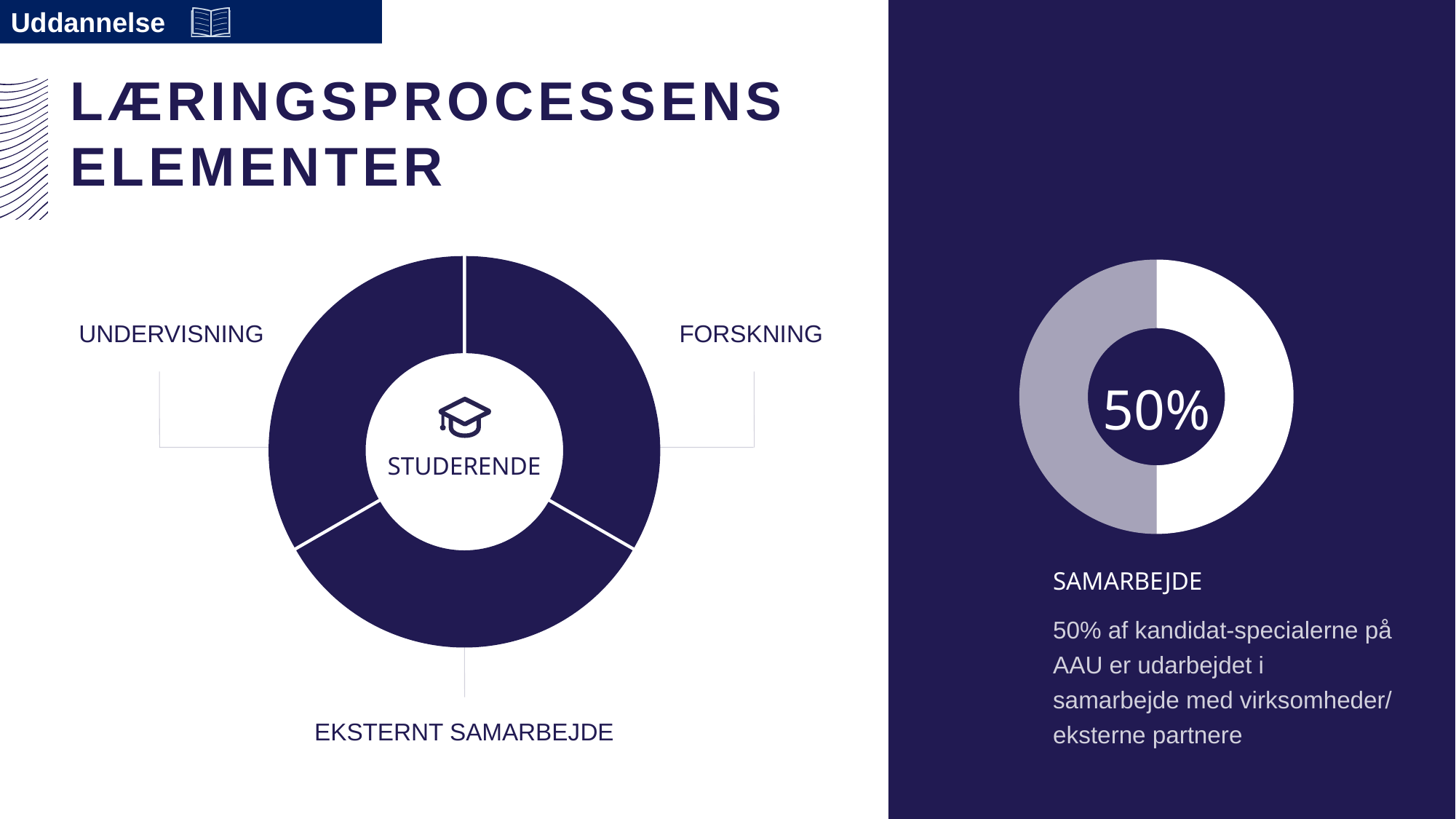
On the right-hand chart, how many segments does the donut have? 2 On the right-hand chart, what share of the donut does the white segment represent? 50% On the left-hand donut diagram, which label is attached to the bottom segment? EKSTERNT SAMARBEJDE On the left-hand donut diagram, which label is attached to the upper-left segment? UNDERVISNING What kind of chart is shown on the right-hand side of the slide? Donut (pie) chart What kind of chart is the diagram on the left-hand side of the slide? Donut (pie) chart On the left-hand donut diagram, how many segments are there? 3 On the left-hand donut diagram, what label is in the centre of the ring? STUDERENDE On the right-hand chart, is the value shown greater or less than 40%? greater On the left-hand donut diagram, which label is attached to the upper-right segment? FORSKNING On the right-hand chart, what label appears below the donut? SAMARBEJDE On the right-hand chart, what percentage is shown in the centre of the donut? 50%